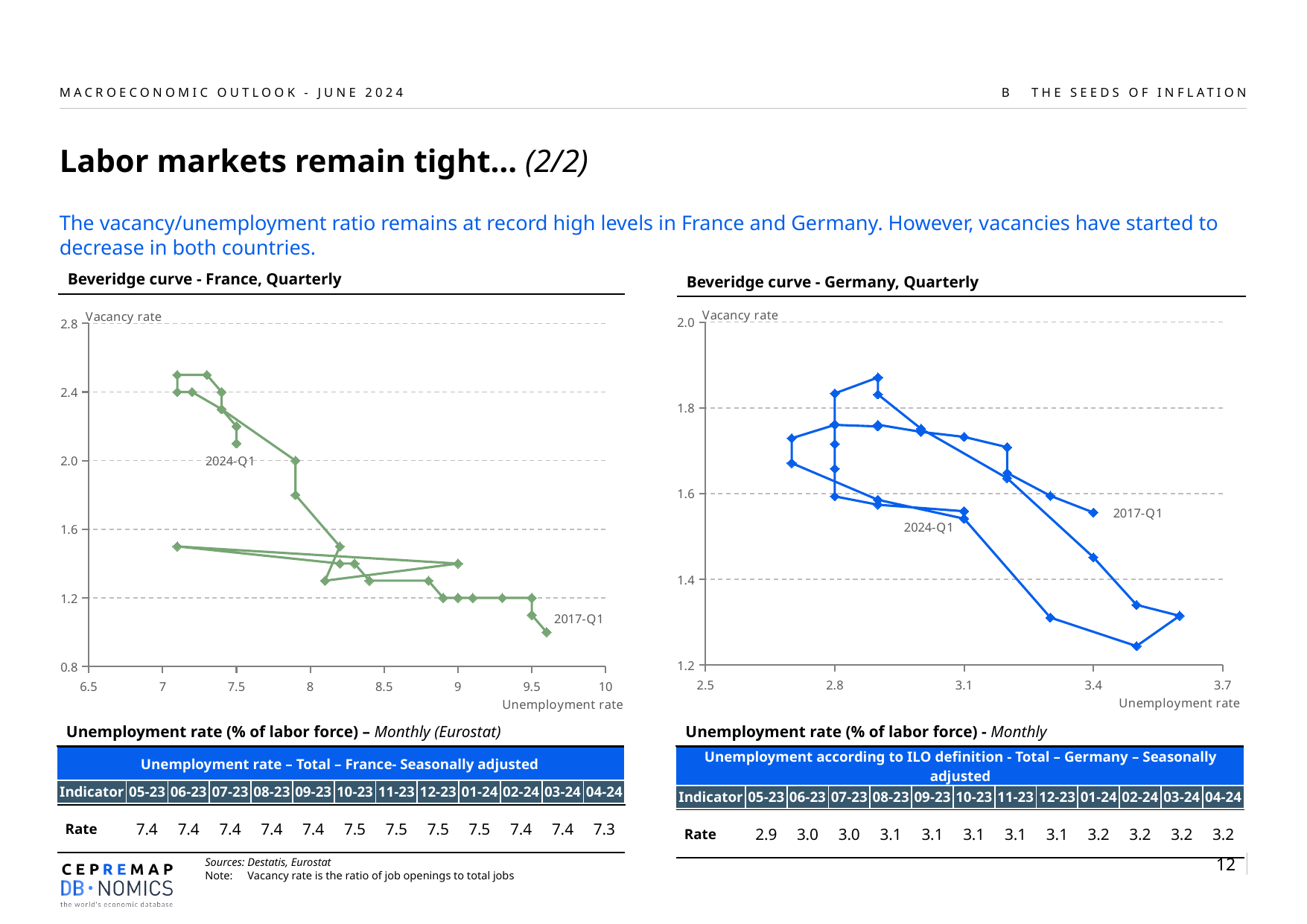
In the 'Beveridge curve - Germany, Quarterly' chart, is the unemployment rate for 2017-Q1 greater or less than 3.1? greater In the 'Beveridge curve - France, Quarterly' chart, is the unemployment rate for 2024-Q1 greater or less than 8? less In the 'Beveridge curve - France, Quarterly' chart, is the vacancy rate for 2017-Q1 greater or less than 1.2? less What kind of chart is the 'Beveridge curve - France, Quarterly' chart? line chart In the 'Beveridge curve - Germany, Quarterly' chart, which of the two labelled points has the higher unemployment rate, 2017-Q1 or 2024-Q1? 2017-Q1 In the 'Beveridge curve - France, Quarterly' chart, what variable is plotted on the x axis? Unemployment rate In the 'Beveridge curve - Germany, Quarterly' chart, what variable is plotted on the y axis? Vacancy rate In the 'Beveridge curve - France, Quarterly' chart, which of the two labelled points has the higher vacancy rate, 2017-Q1 or 2024-Q1? 2024-Q1